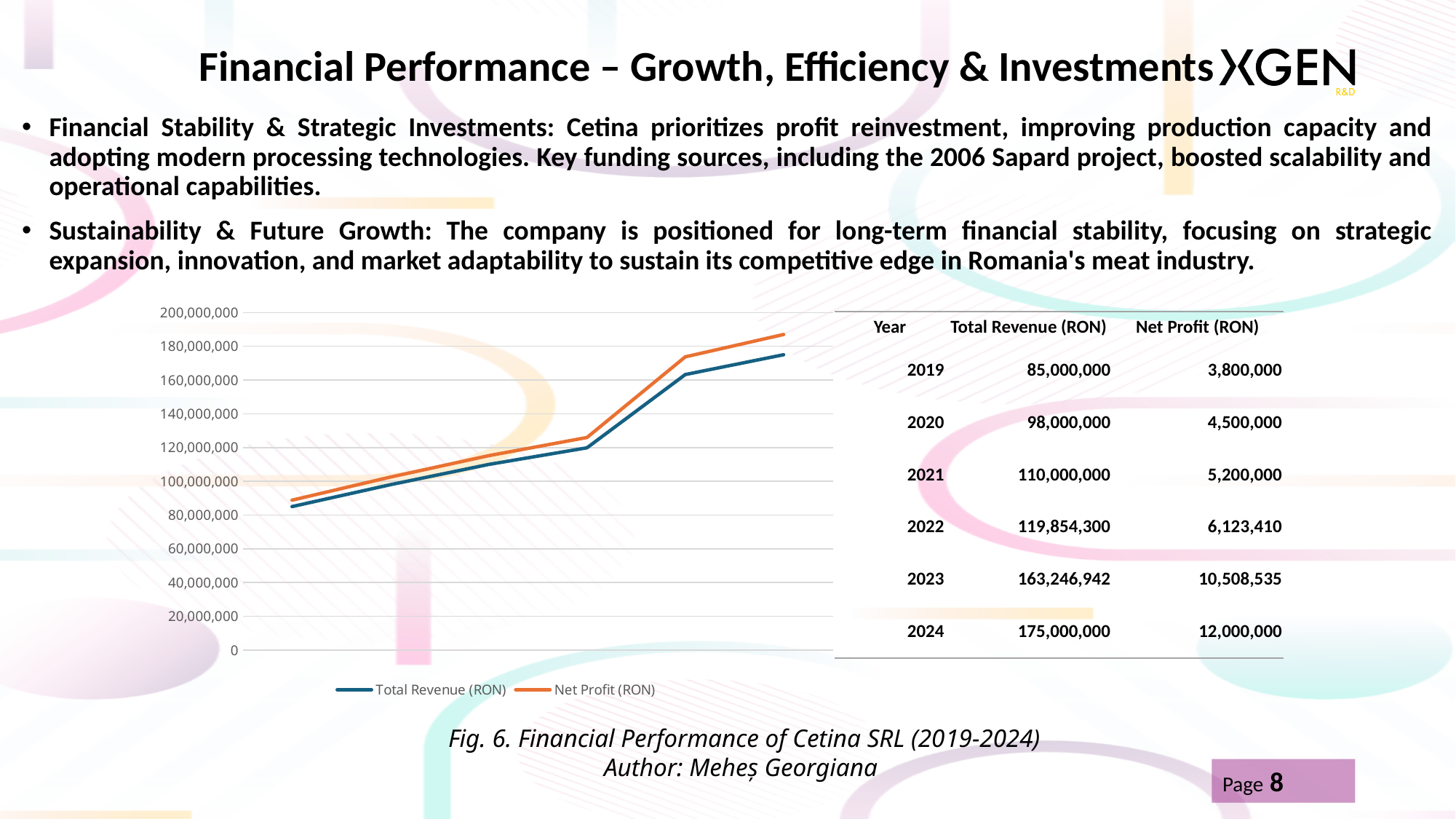
What is the difference in Net Profit (RON) between 2024 and 2023? 1,491,465 Is Total Revenue (RON) in 2021 larger or smaller than in 2022? smaller What is the difference in Total Revenue (RON) between 2020 and 2019? 13,000,000 How many series does the chart legend list? 2 Which year has the lowest Net Profit (RON)? 2019 What are the two series named in the chart legend? Total Revenue (RON) and Net Profit (RON) Which year has the highest Total Revenue (RON)? 2024 Does the Total Revenue (RON) line rise or fall from 2019 to 2024? rises What kind of chart is shown on the slide? line chart How many years of data are plotted in the chart? 6 According to the table next to the chart, what was Total Revenue (RON) in 2023? 163,246,942 According to the table next to the chart, what was Net Profit (RON) in 2022? 6,123,410